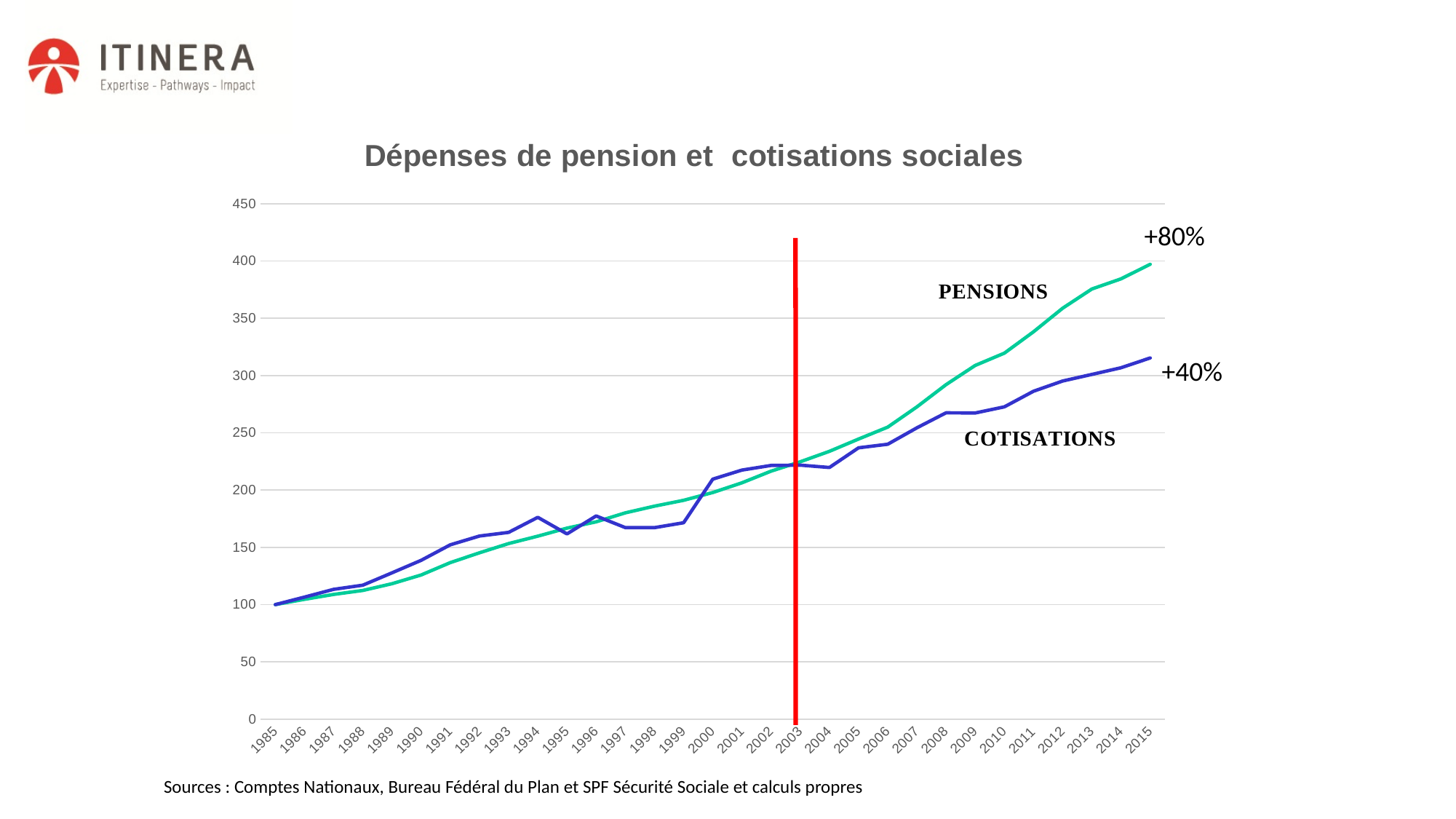
Is the value for PENSIONS in 1990 greater or less than 150? less At which year is the red vertical line drawn on the chart? 2003 Which series has the higher value in 2015, PENSIONS or COTISATIONS? PENSIONS Is the value for COTISATIONS in 2004 greater or less than 250? less Is the value for PENSIONS in 2015 greater or less than 350? greater How many years are shown along the x axis? 31 What kind of chart is shown on the slide? line chart What is the value of both series in 1985? 100 How many series are plotted on the chart? 2 Do the PENSIONS values generally rise or fall from 1985 to 2015? rise What is the title of the chart? Dépenses de pension et cotisations sociales